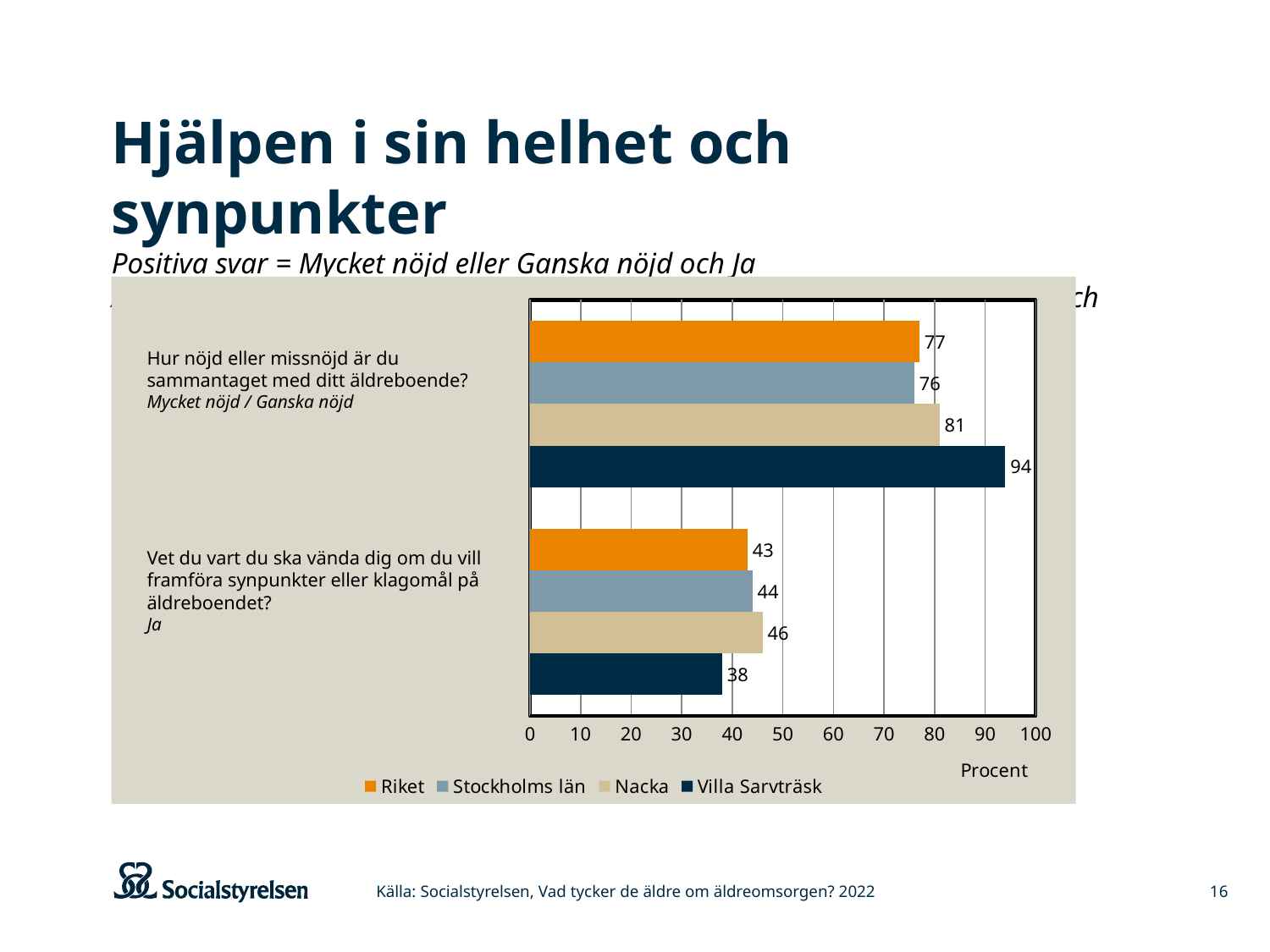
For the question "Vet du vart du ska vända dig om du vill framföra synpunkter eller klagomål på äldreboendet?", which is larger: the value for Nacka or the value for Villa Sarvträsk? Nacka What kind of chart is shown on the slide? bar chart What is the value for Villa Sarvträsk for the question "Hur nöjd eller missnöjd är du sammantaget med ditt äldreboende?"? 94 Which series has the highest value for the question "Hur nöjd eller missnöjd är du sammantaget med ditt äldreboende?"? Villa Sarvträsk What is the difference between the Villa Sarvträsk and Riket values for the question "Hur nöjd eller missnöjd är du sammantaget med ditt äldreboende?"? 17 What is the value for Riket for the question "Vet du vart du ska vända dig om du vill framföra synpunkter eller klagomål på äldreboendet?"? 43 Which series has the lowest value for the question "Vet du vart du ska vända dig om du vill framföra synpunkter eller klagomål på äldreboendet?"? Villa Sarvträsk What is the value for Nacka for the question "Hur nöjd eller missnöjd är du sammantaget med ditt äldreboende?"? 81 Is the value for Stockholms län for the question "Vet du vart du ska vända dig om du vill framföra synpunkter eller klagomål på äldreboendet?" greater or less than 50? less How many series does the legend list? 4 What unit is shown on the horizontal axis of the chart? Procent What is the difference between the Nacka and Villa Sarvträsk values for the question "Vet du vart du ska vända dig om du vill framföra synpunkter eller klagomål på äldreboendet?"? 8